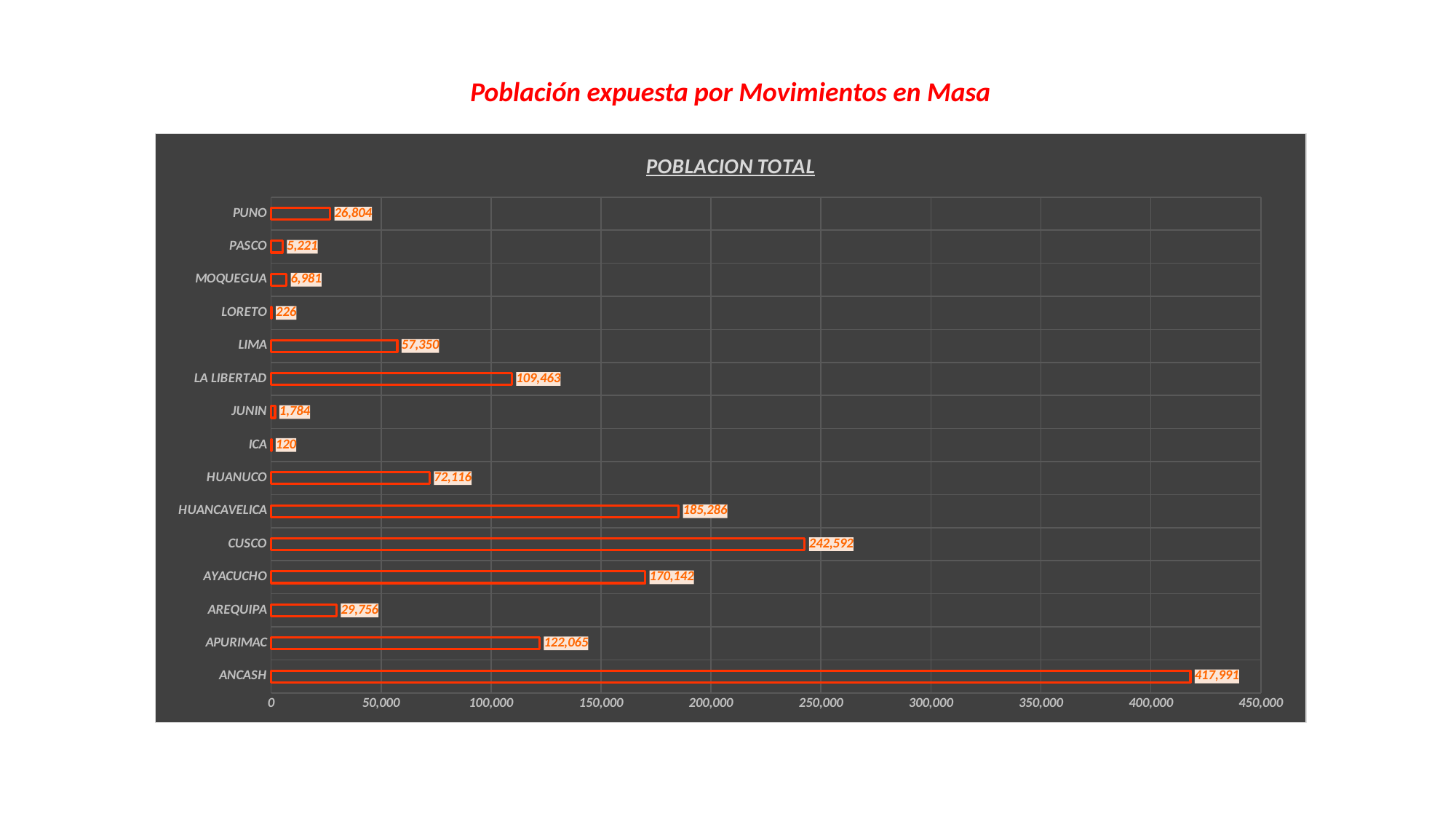
What is the title of the chart? POBLACION TOTAL What is the difference between the values for CUSCO and HUANCAVELICA? 57,306 What is the value for HUANCAVELICA? 185,286 Which category has the highest value? ANCASH What is the difference between the values for ANCASH and CUSCO? 175,399 What kind of chart is shown on the slide? bar chart Is the value for AYACUCHO greater or less than 150,000? greater Which category has the lowest value? ICA What is the value for ANCASH? 417,991 How many categories are shown in the chart? 15 What is the value for LORETO? 226 Which is larger, the value for LA LIBERTAD or the value for APURIMAC? APURIMAC